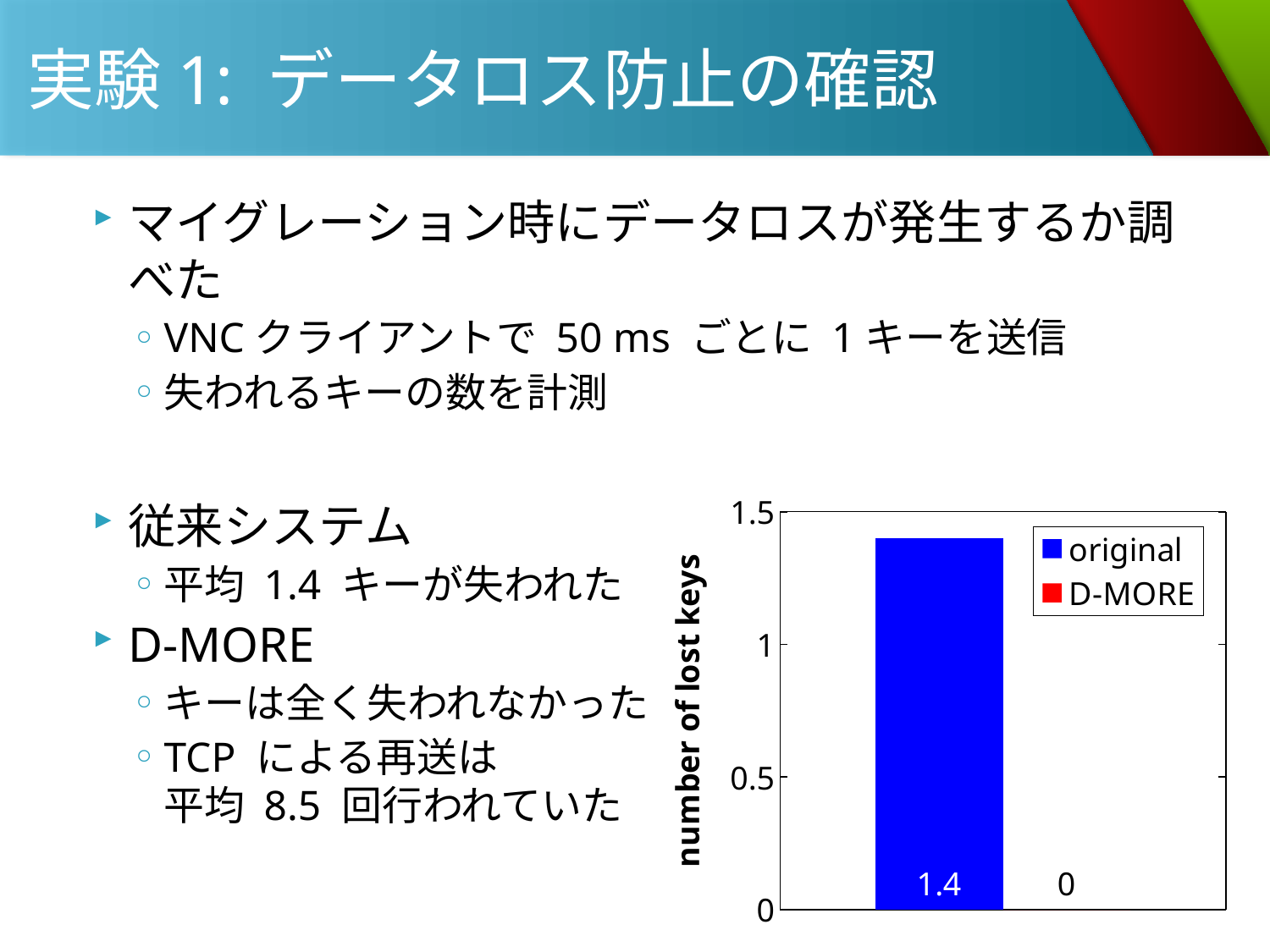
What is the number of lost keys for D-MORE? 0 How many series does the legend list? 2 Is the number of lost keys for original greater or less than 1.5? less Which series has the lowest number of lost keys? D-MORE What is the label of the y axis? number of lost keys What is the number of lost keys for original? 1.4 What is the maximum value shown on the y axis? 1.5 Which series has the higher number of lost keys? original Is the number of lost keys for original greater or less than 1? greater What is the difference in number of lost keys between original and D-MORE? 1.4 What colour is the bar for original? blue What kind of chart is shown on the slide? bar chart